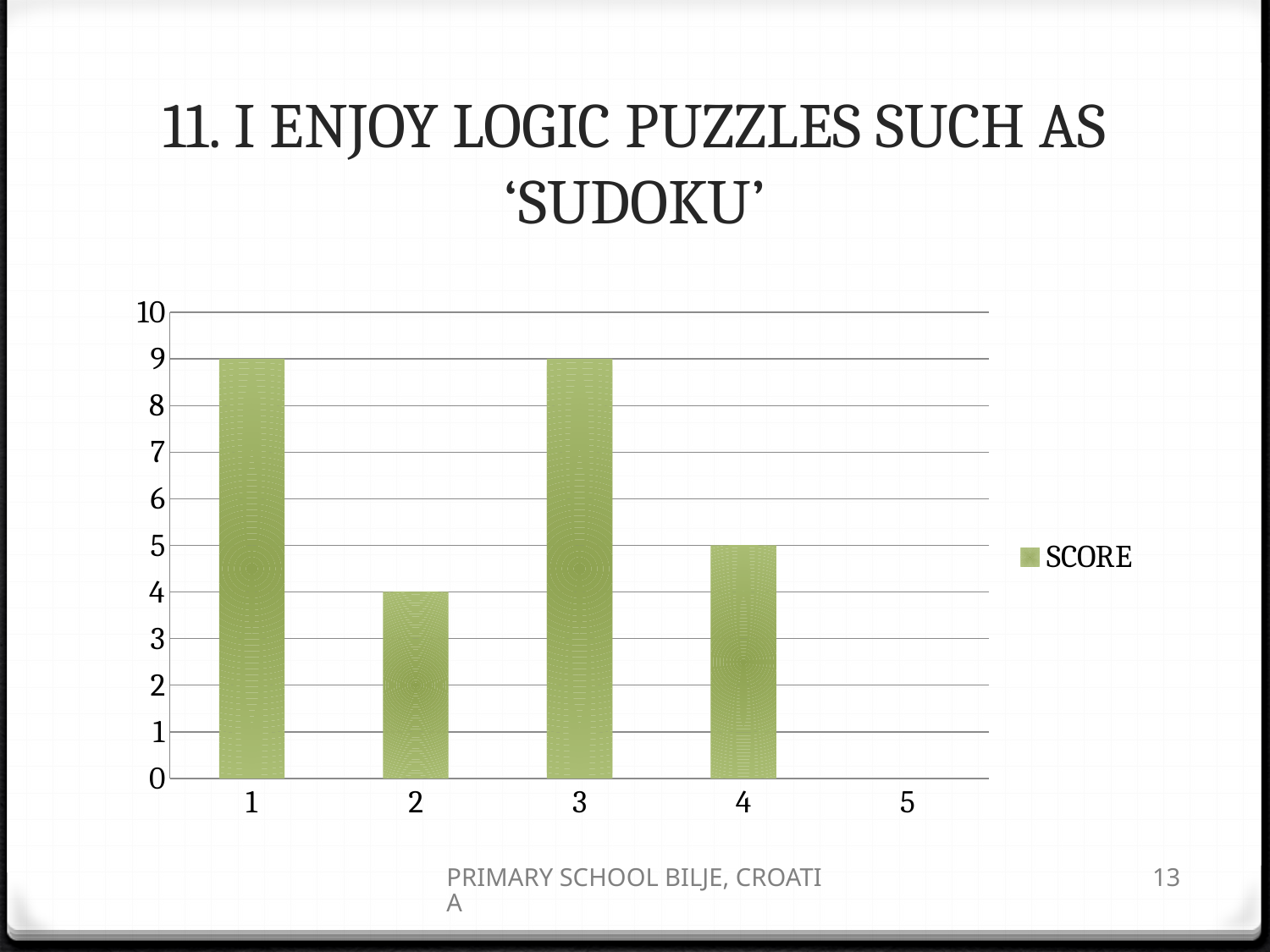
What is the value for category 1? 9 What is the value for category 2? 4 What is the value for category 4? 5 What is the difference between the values for category 1 and category 2? 5 Which has a larger value, category 2 or category 4? 4 How many categories are shown on the x axis? 5 What is the difference between the values for category 3 and category 4? 4 What kind of chart is shown on the slide? bar chart What is the value for category 3? 9 How many series does the legend list? 1 Is the value for category 1 greater or less than 5? greater Which category has the lowest value? 5